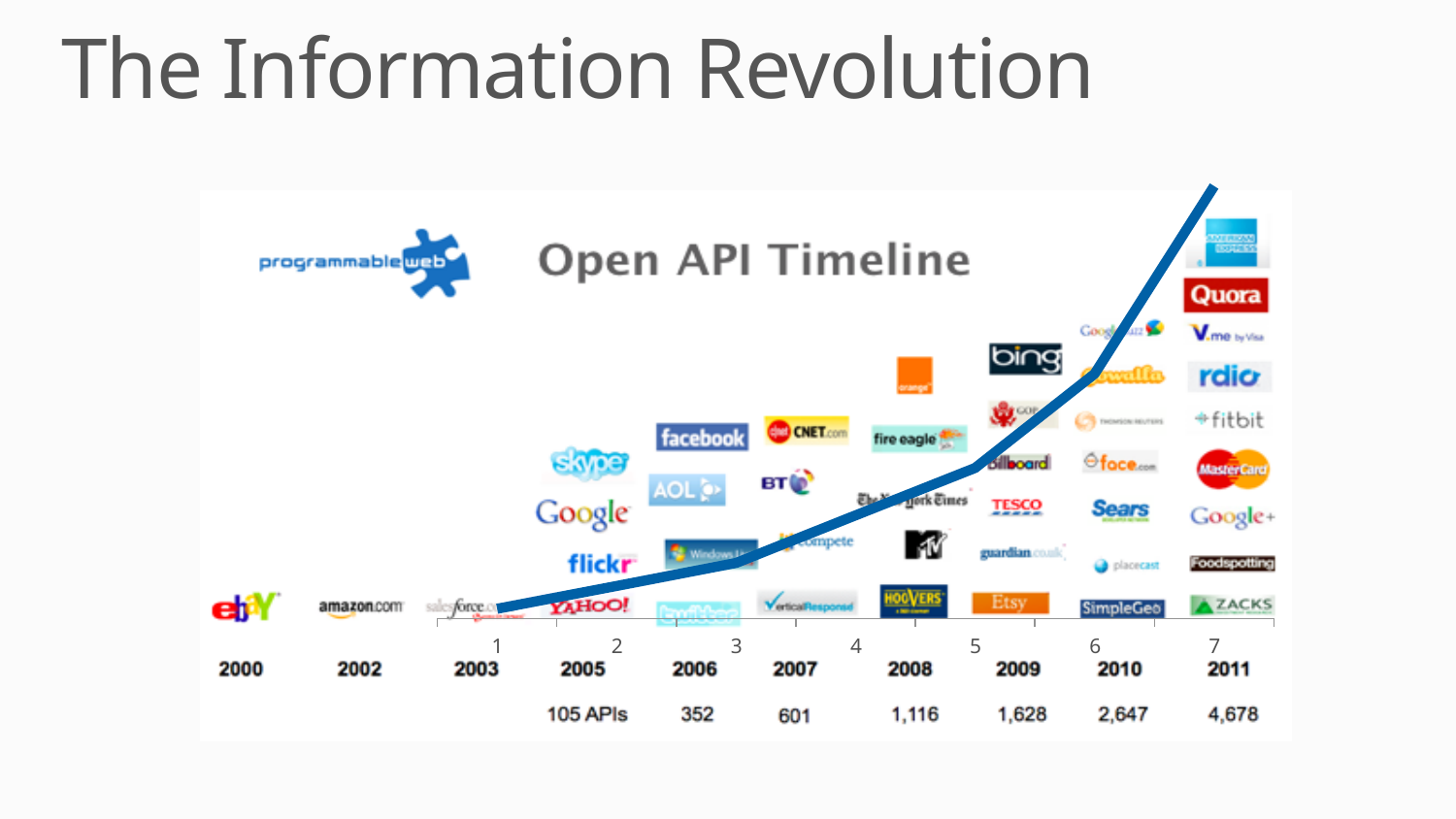
How many numbered points does the overlaid line chart have on its x axis? 7 Which year has the lowest printed API count on the Open API Timeline? 2005 What value is printed for 2009 on the Open API Timeline? 1,628 How many APIs are listed for 2005 on the Open API Timeline? 105 APIs What value is printed for 2008 on the Open API Timeline? 1,116 What value is printed for 2011 on the Open API Timeline? 4,678 What kind of chart is overlaid on the Open API Timeline image? line chart Which is larger on the Open API Timeline, the value for 2007 or the value for 2006? 2007 Do the API counts rise or fall from 2005 to 2011 on the Open API Timeline? rise What is the difference between the API counts for 2011 and 2010 on the Open API Timeline? 2,031 What is the title of the chart shown on the slide? Open API Timeline Which year has the highest API count on the Open API Timeline? 2011